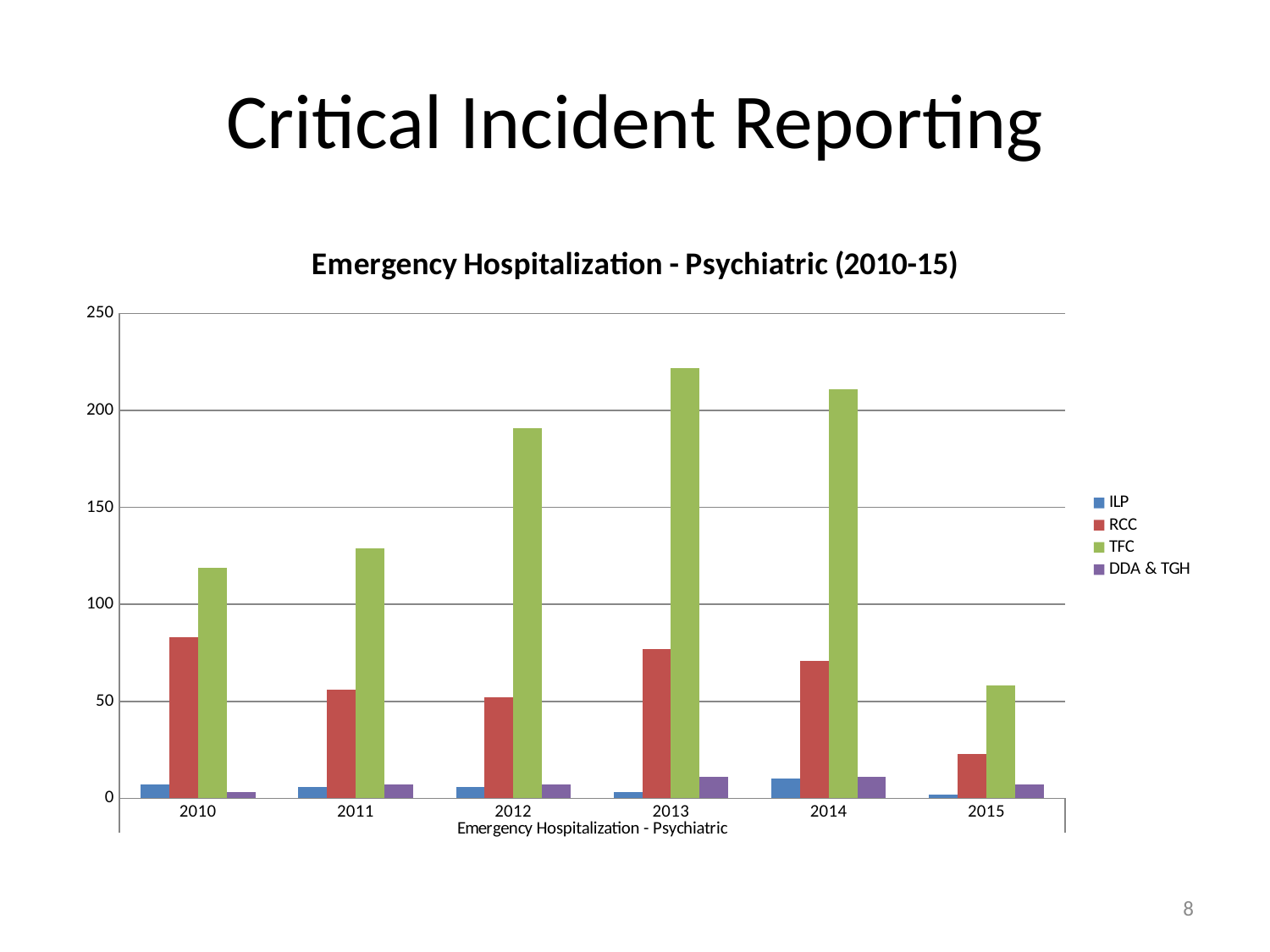
What kind of chart is shown on the slide? bar chart In which year is the TFC value highest? 2013 In which year is the RCC value highest? 2010 Is the RCC value for 2010 greater or less than 100? less Does the TFC value rise or fall from 2010 to 2013? rise Is the TFC value for 2012 greater or less than 150? greater What is the title of the chart? Emergency Hospitalization - Psychiatric (2010-15) In 2011, which is larger, the TFC value or the RCC value? TFC Is the TFC value for 2015 greater or less than 100? less How many years are shown along the x axis? 6 How many series does the legend list? 4 In which year is the TFC value lowest? 2015